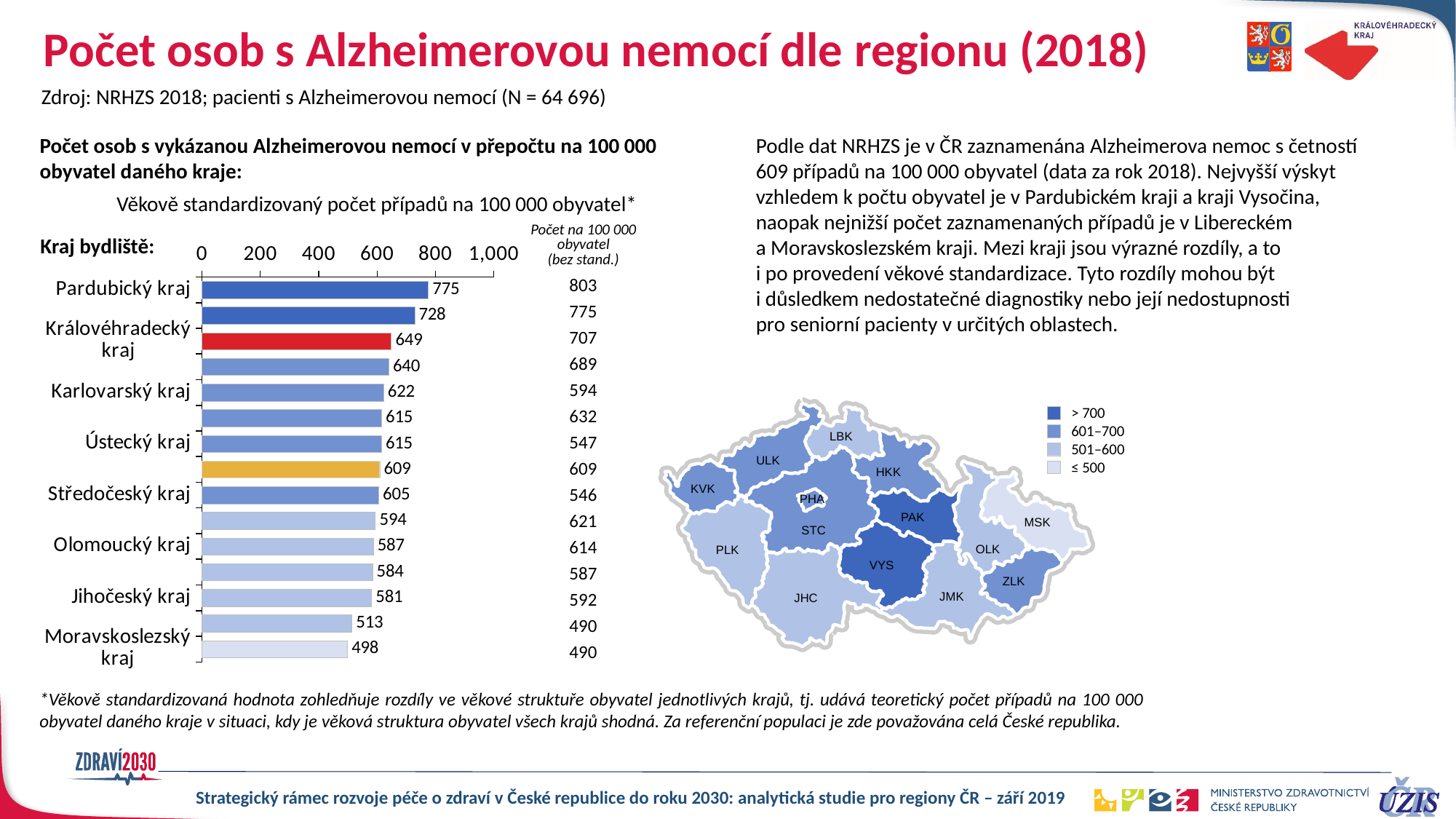
What is the difference between the values for Pardubický kraj and Moravskoslezský kraj? 277 Which has a larger value, Středočeský kraj or Olomoucký kraj? Středočeský kraj What is the age-standardized value for Ústecký kraj? 615 Which region has the lowest bar in the chart? Moravskoslezský kraj What is the age-standardized value for Královéhradecký kraj? 649 Is the value for Jihočeský kraj greater or less than 600? less What is the age-standardized value for Pardubický kraj? 775 What is the age-standardized value for Karlovarský kraj? 622 What is the age-standardized value for Moravskoslezský kraj? 498 Which region has the highest bar in the chart? Pardubický kraj What type of chart is shown on the slide? bar chart How many bars are plotted in the chart? 15